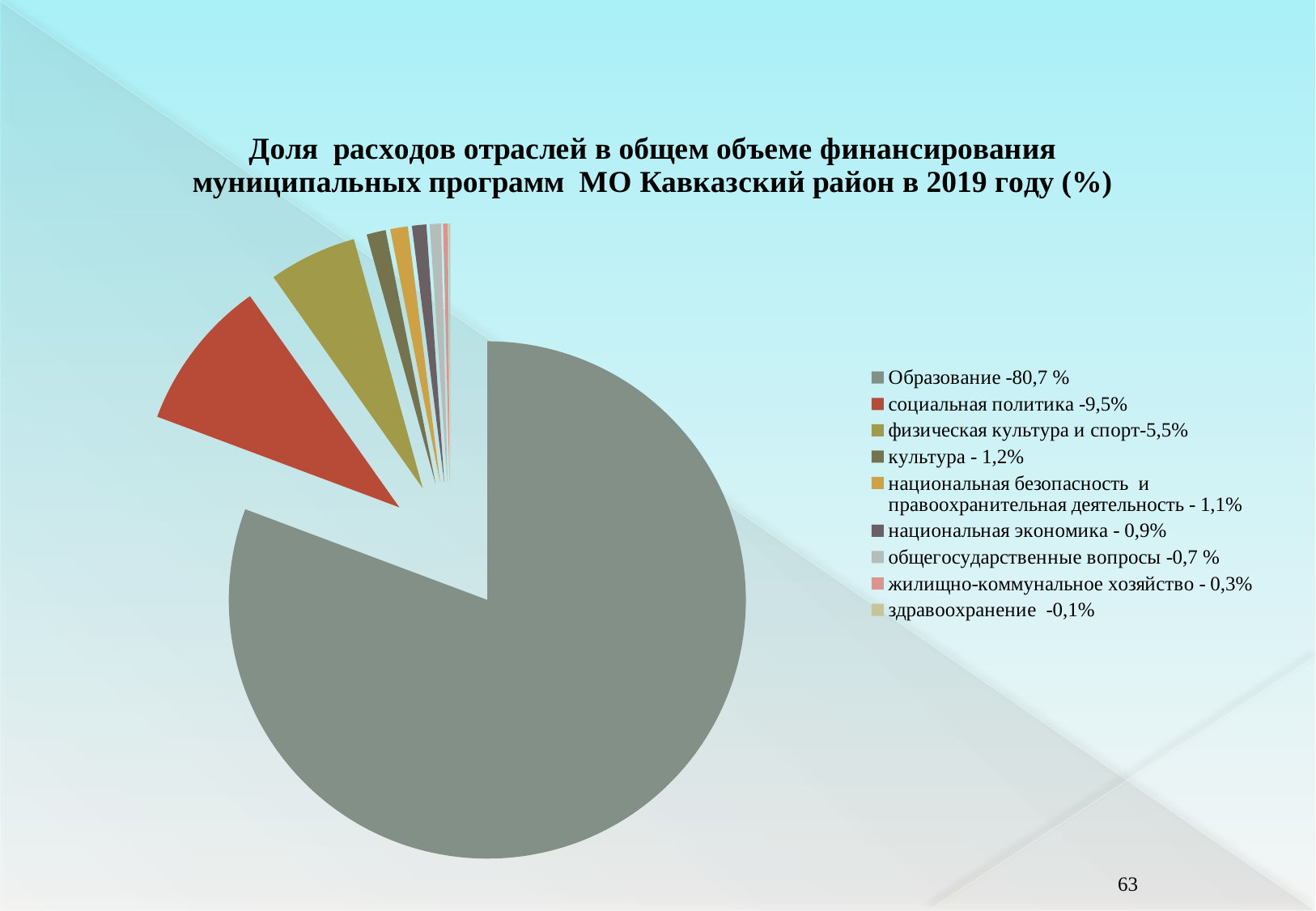
What share does Образование have in the pie chart? 80,7 % What is the value for национальная экономика? 0,9% Which category has the largest share of the pie? Образование How many categories does the pie chart show? 9 What is the difference in percentage points between Образование and социальная политика? 71,2 What is the difference in percentage points between культура and национальная безопасность и правоохранительная деятельность? 0,1 What is the value for жилищно-коммунальное хозяйство? 0,3% Which is larger: социальная политика or физическая культура и спорт? социальная политика What is the value for физическая культура и спорт? 5,5% Which category has the smallest share of the pie? здравоохранение What is the value for социальная политика? 9,5% What kind of chart is shown on the slide? pie chart